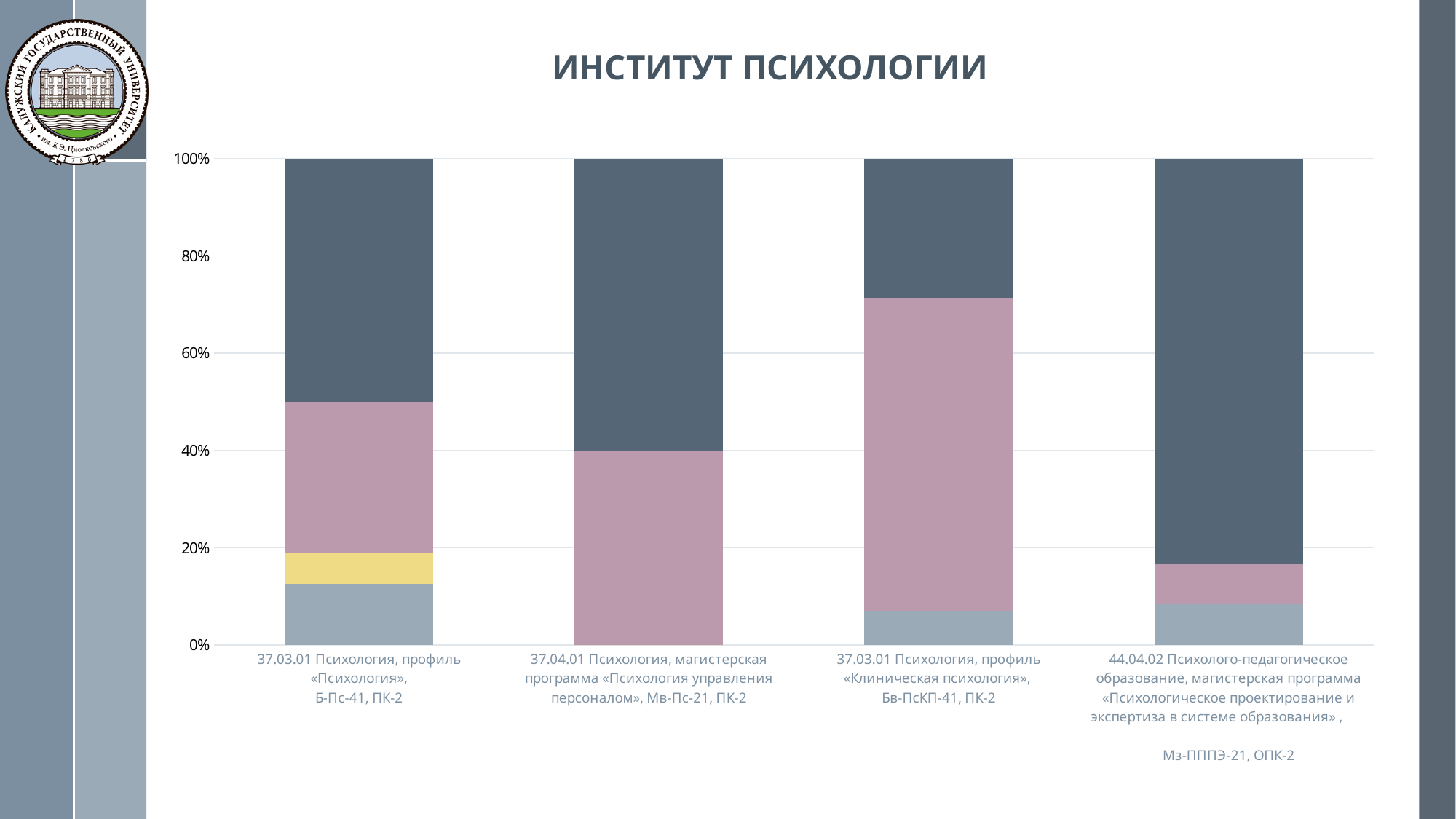
What is the title of the slide above the chart? ИНСТИТУТ ПСИХОЛОГИИ How many categories (bars) are shown on the x axis of the chart? 4 Which category has the largest dark top segment? 44.04.02 Психолого-педагогическое образование, Мз-ПППЭ-21, ОПК-2 What is the total height of the stacked bar for «Клиническая психология», Бв-ПсКП-41, ПК-2? 100% Does the top of the pink segment in the bar for «Клиническая психология», Бв-ПсКП-41, ПК-2 lie above or below the 60% line? above Which bar has the larger pink segment: «Клиническая психология», Бв-ПсКП-41, ПК-2 or 44.04.02 Психолого-педагогическое образование, Мз-ПППЭ-21, ОПК-2? «Клиническая психология», Бв-ПсКП-41, ПК-2 What kind of chart is shown on the slide? Stacked bar chart Is the dark top segment of the bar for 44.04.02 Психолого-педагогическое образование, Мз-ПППЭ-21, ОПК-2 greater or less than 80%? greater Which category's bar contains a yellow segment? 37.03.01 Психология, профиль «Психология», Б-Пс-41, ПК-2 Which category has the largest pink segment? 37.03.01 Психология, профиль «Клиническая психология», Бв-ПсКП-41, ПК-2 Is the dark top segment of the bar for 37.04.01 Психология, Мв-Пс-21, ПК-2 greater or less than 50%? greater